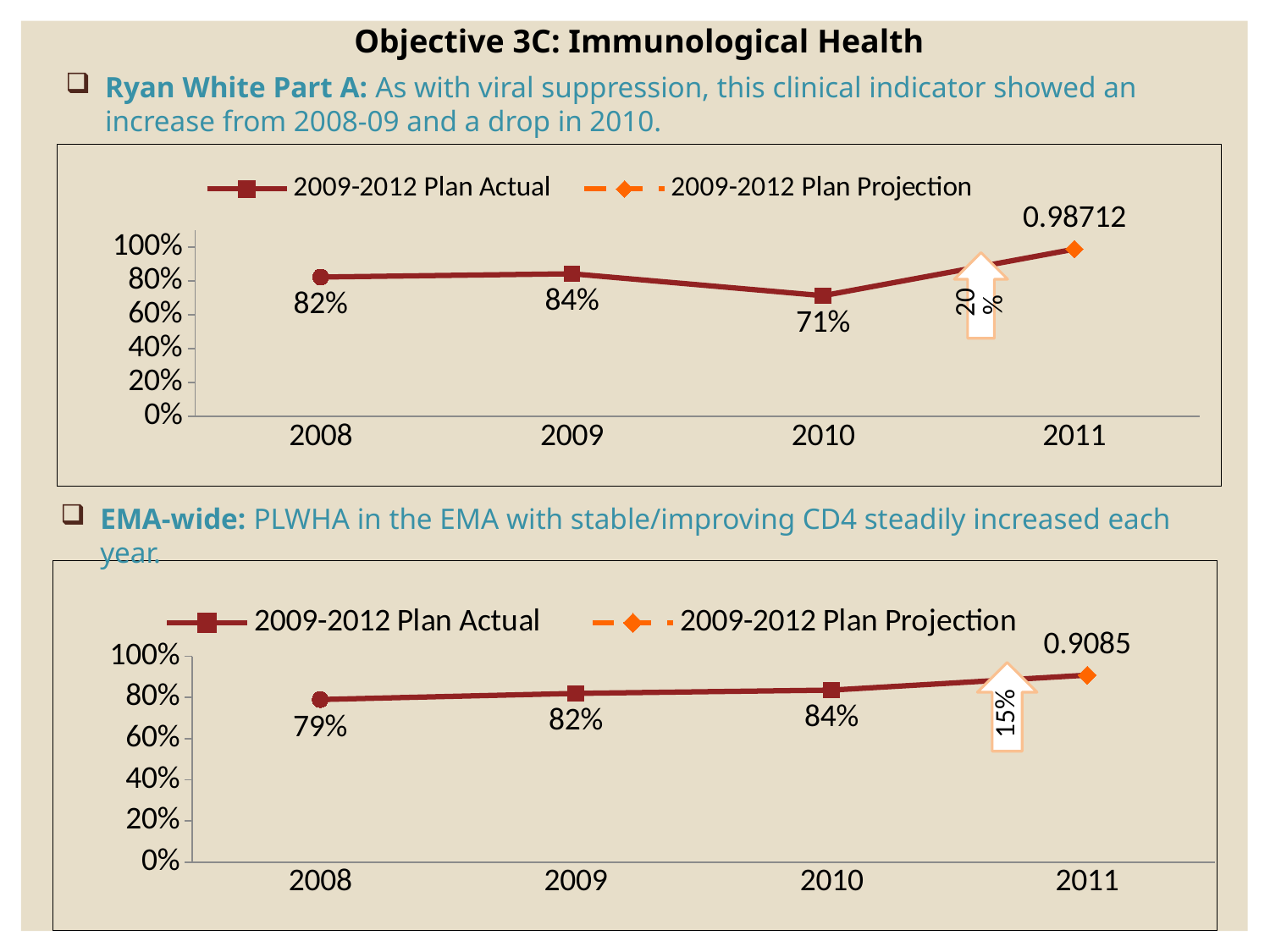
In the top chart (Ryan White Part A), which year has the lowest 2009-2012 Plan Actual value? 2010 In the bottom chart (EMA-wide), what is the difference between the 2010 and 2008 Plan Actual values? 5% In the bottom chart (EMA-wide), how many years are shown on the x axis? 4 In the bottom chart (EMA-wide), do the Plan Actual values rise or fall from 2008 to 2010? rise In the top chart (Ryan White Part A), how many series does the legend list? 2 In the bottom chart (EMA-wide), what is the 2009-2012 Plan Projection value labelled for 2011? 0.9085 In the bottom chart (EMA-wide), what is the 2009-2012 Plan Actual value for 2008? 79% In the top chart (Ryan White Part A), what is the 2009-2012 Plan Projection value labelled for 2011? 0.98712 In the top chart (Ryan White Part A), what is the difference between the 2009 and 2010 Plan Actual values? 13% In the top chart (Ryan White Part A), what is the 2009-2012 Plan Actual value for 2009? 84% What type of chart is the bottom chart (EMA-wide)? line chart In the top chart (Ryan White Part A), what is the 2009-2012 Plan Actual value for 2010? 71%